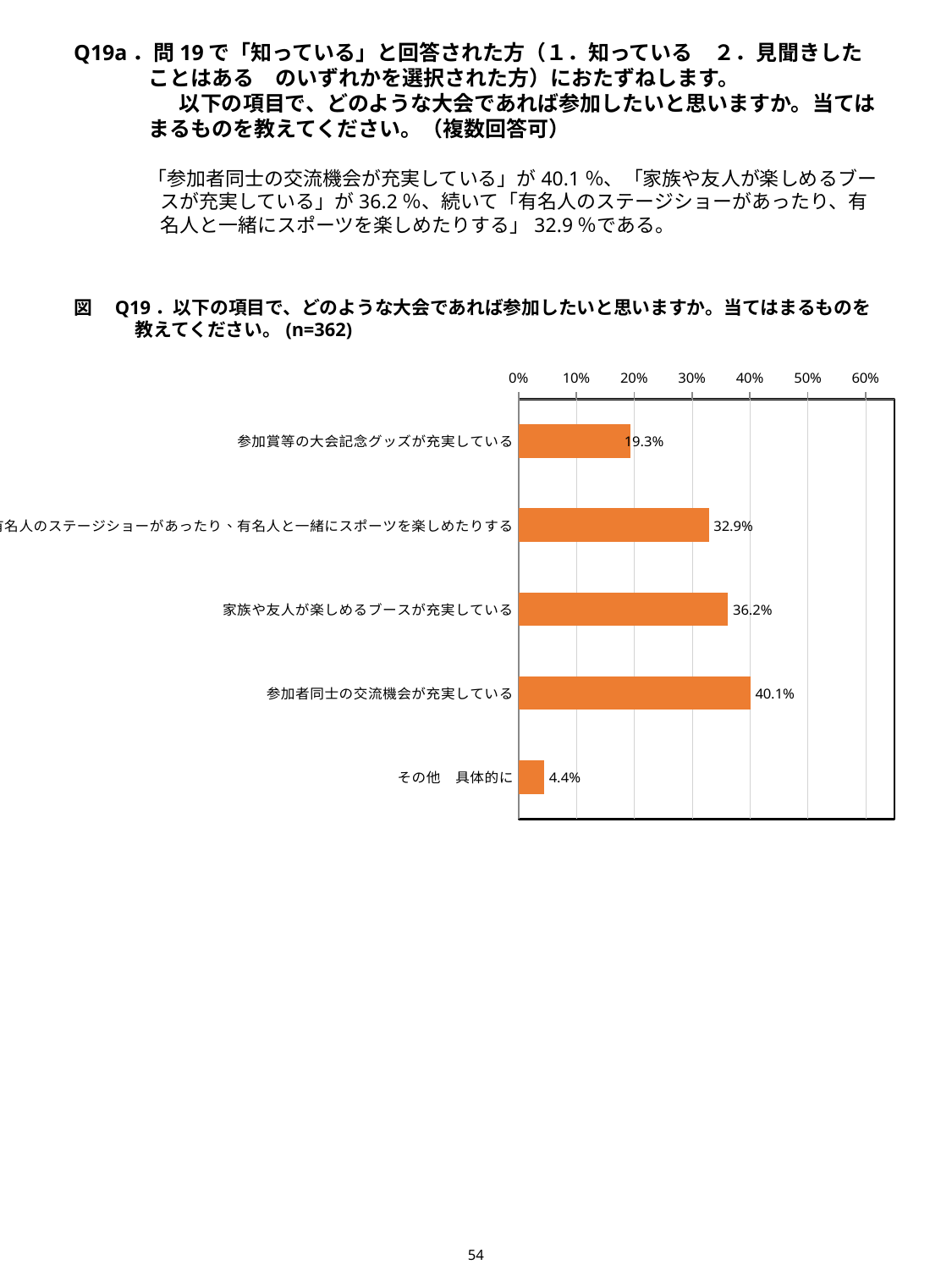
Which category has the highest value? 参加者同士の交流機会が充実している What is the value shown on the second bar from the top? 32.9% What is the value for その他 具体的に? 4.4% What is the value for 家族や友人が楽しめるブースが充実している? 36.2% What is the value for 参加賞等の大会記念グッズが充実している? 19.3% How many categories are shown in the chart? 5 What is the value for 参加者同士の交流機会が充実している? 40.1% What is the difference between the values for 参加者同士の交流機会が充実している and 家族や友人が楽しめるブースが充実している? 3.9% What kind of chart is shown on the slide? bar chart Which category has the lowest value? その他 具体的に Is the value for 参加賞等の大会記念グッズが充実している greater or less than 20%? less Which is larger, the value for 参加賞等の大会記念グッズが充実している or the value for 家族や友人が楽しめるブースが充実している? 家族や友人が楽しめるブースが充実している